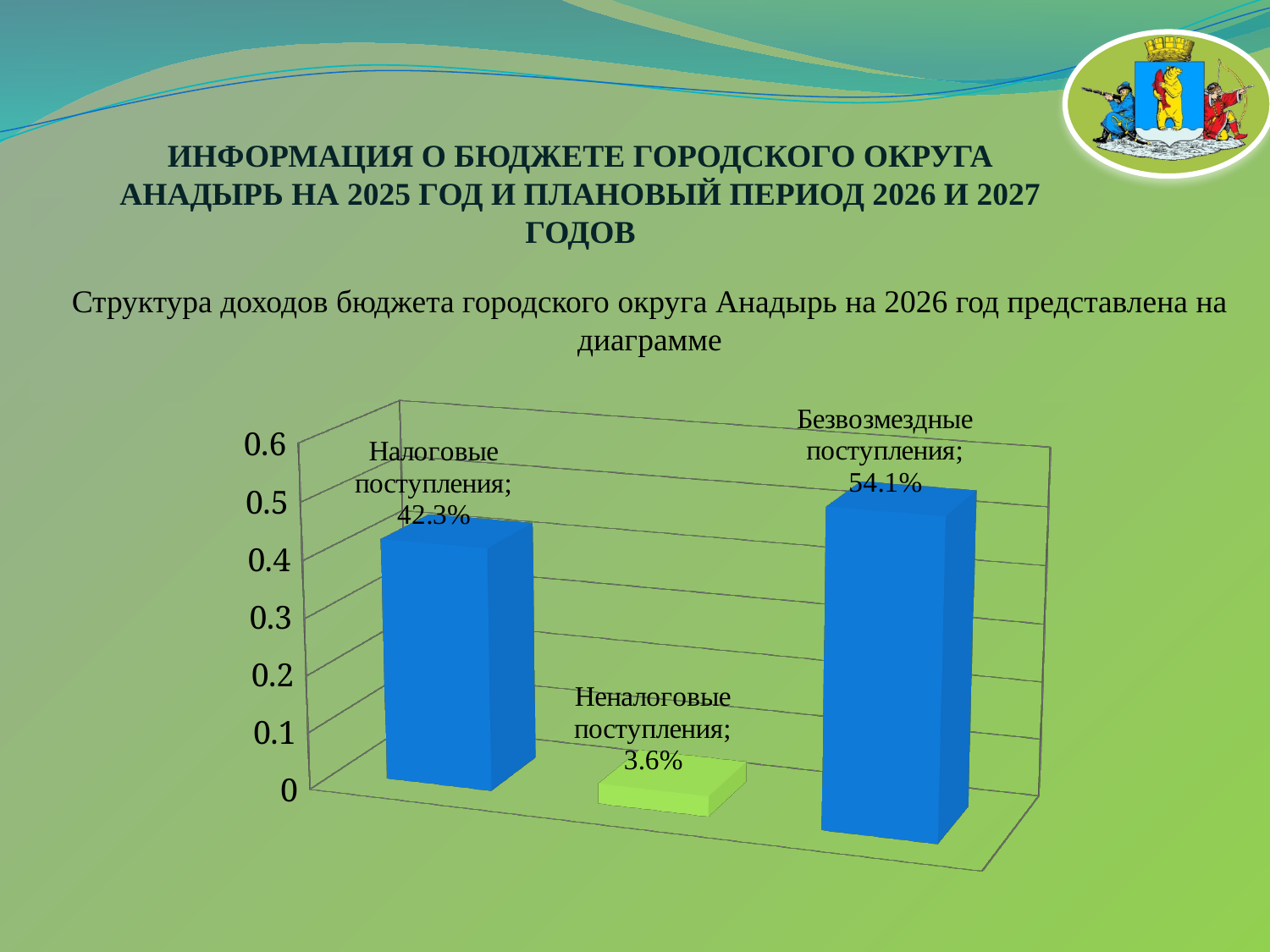
What kind of chart is shown on the slide? bar chart What is the value shown for Налоговые поступления? 42.3% Which category has the lowest value? Неналоговые поступления Is the value for Налоговые поступления greater or less than 0.5? less What is the difference between Налоговые поступления and Неналоговые поступления? 38.7% How many categories are shown in the chart? 3 Which category has the highest value? Безвозмездные поступления What is the difference between Безвозмездные поступления and Налоговые поступления? 11.8% What is the value shown for Неналоговые поступления? 3.6% What is the highest value shown on the vertical axis? 0.6 Which is larger, Налоговые поступления or Безвозмездные поступления? Безвозмездные поступления What is the value shown for Безвозмездные поступления? 54.1%